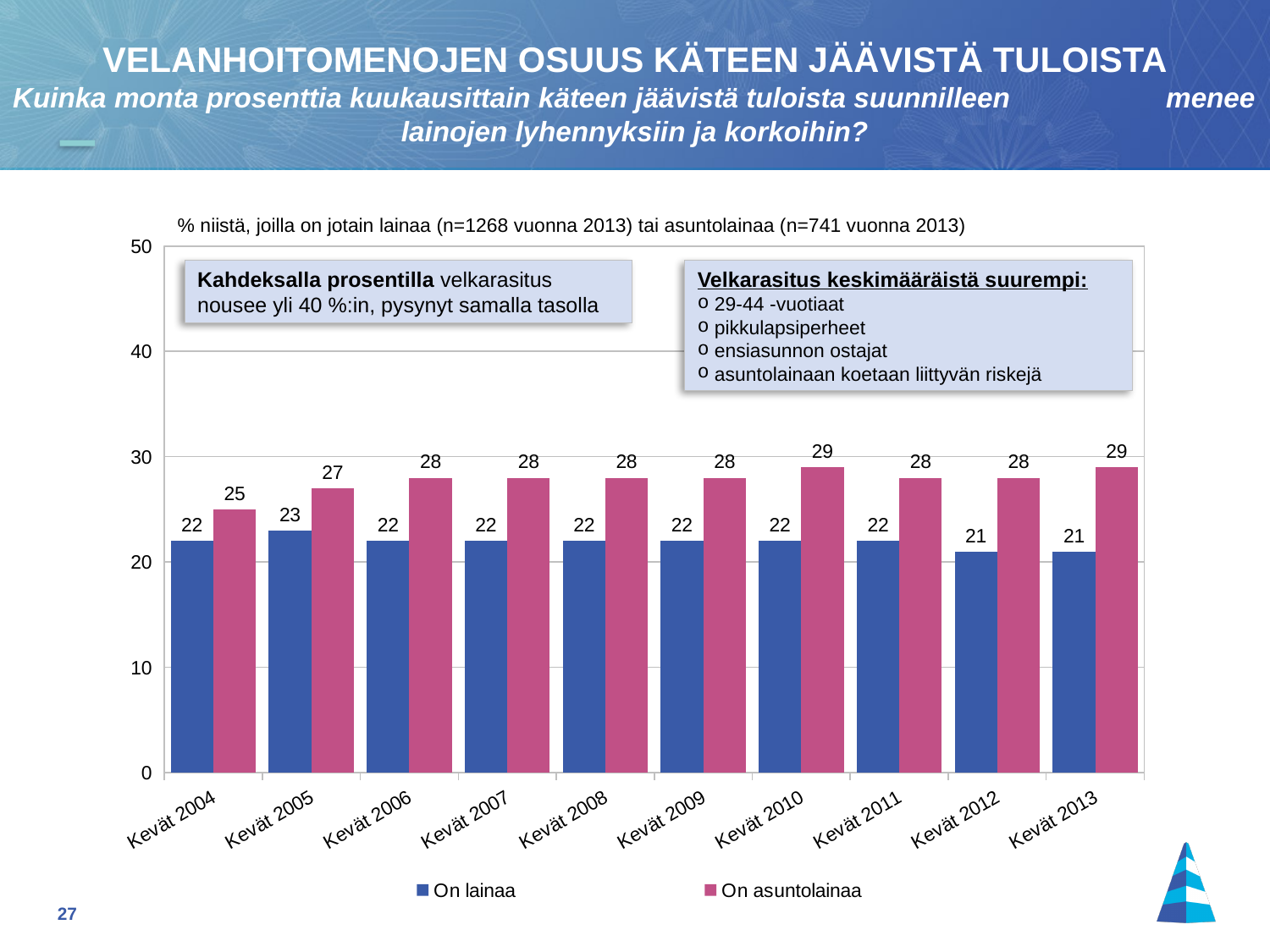
What is the value for "On lainaa" in Kevät 2012? 21 What are the two series named in the legend? On lainaa and On asuntolainaa What is the value for "On asuntolainaa" in Kevät 2004? 25 Which is larger in Kevät 2005: the "On lainaa" value or the "On asuntolainaa" value? On asuntolainaa What is the difference between the "On asuntolainaa" and "On lainaa" values in Kevät 2013? 8 In which year is the "On asuntolainaa" value lowest? Kevät 2004 What is the value for "On lainaa" in Kevät 2005? 23 How many time periods (categories) are shown on the x axis? 10 Is the value for "On asuntolainaa" in Kevät 2010 greater or less than 20? greater What is the value for "On asuntolainaa" in Kevät 2013? 29 How many series does the legend list? 2 What kind of chart is shown on the slide? Bar chart